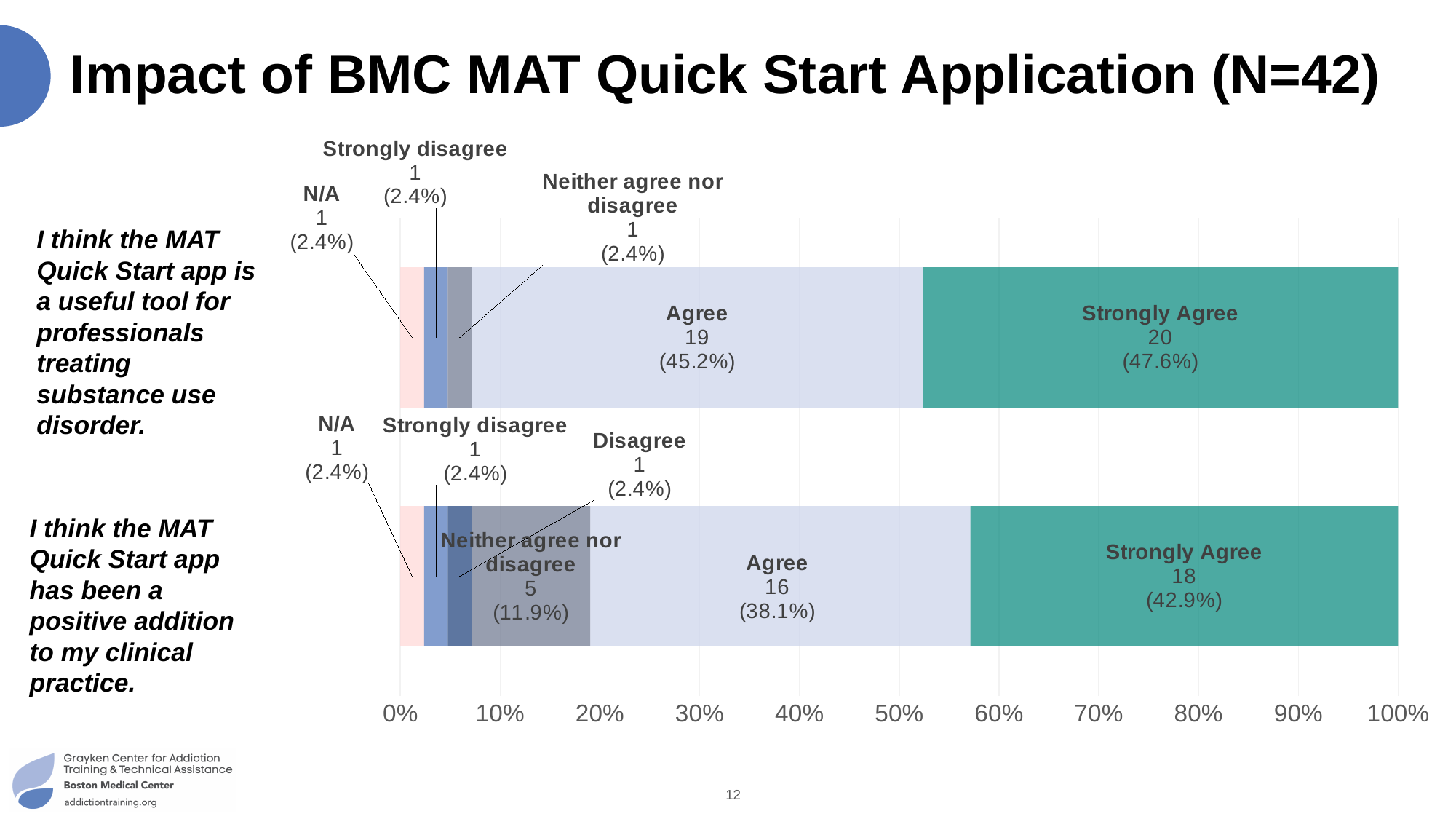
How many respondents selected Neither agree nor disagree for the statement that the MAT Quick Start app has been a positive addition to my clinical practice? 5 How many statements (bars) are plotted in the chart? 2 What is the difference in count between Agree and Neither agree nor disagree for the statement that the MAT Quick Start app has been a positive addition to my clinical practice? 11 What percentage of respondents selected Strongly Agree for the statement that the MAT Quick Start app has been a positive addition to my clinical practice? 42.9% What is the title of the slide containing the chart? Impact of BMC MAT Quick Start Application (N=42) What percentage of respondents selected Agree for the statement that the MAT Quick Start app is a useful tool? 45.2% How many respondents selected Strongly Agree for the statement that the MAT Quick Start app is a useful tool for professionals treating substance use disorder? 20 Which is larger: the Agree count for the 'useful tool' statement or the Agree count for the 'positive addition' statement? The 'useful tool' statement (19) What is the total number of responses across all categories for the statement that the MAT Quick Start app is a useful tool? 42 What is the difference in count between Strongly Agree and Agree for the statement that the MAT Quick Start app is a useful tool? 1 Which response category has the highest count for the statement that the MAT Quick Start app has been a positive addition to my clinical practice? Strongly Agree What kind of chart is shown on the slide? Stacked bar chart